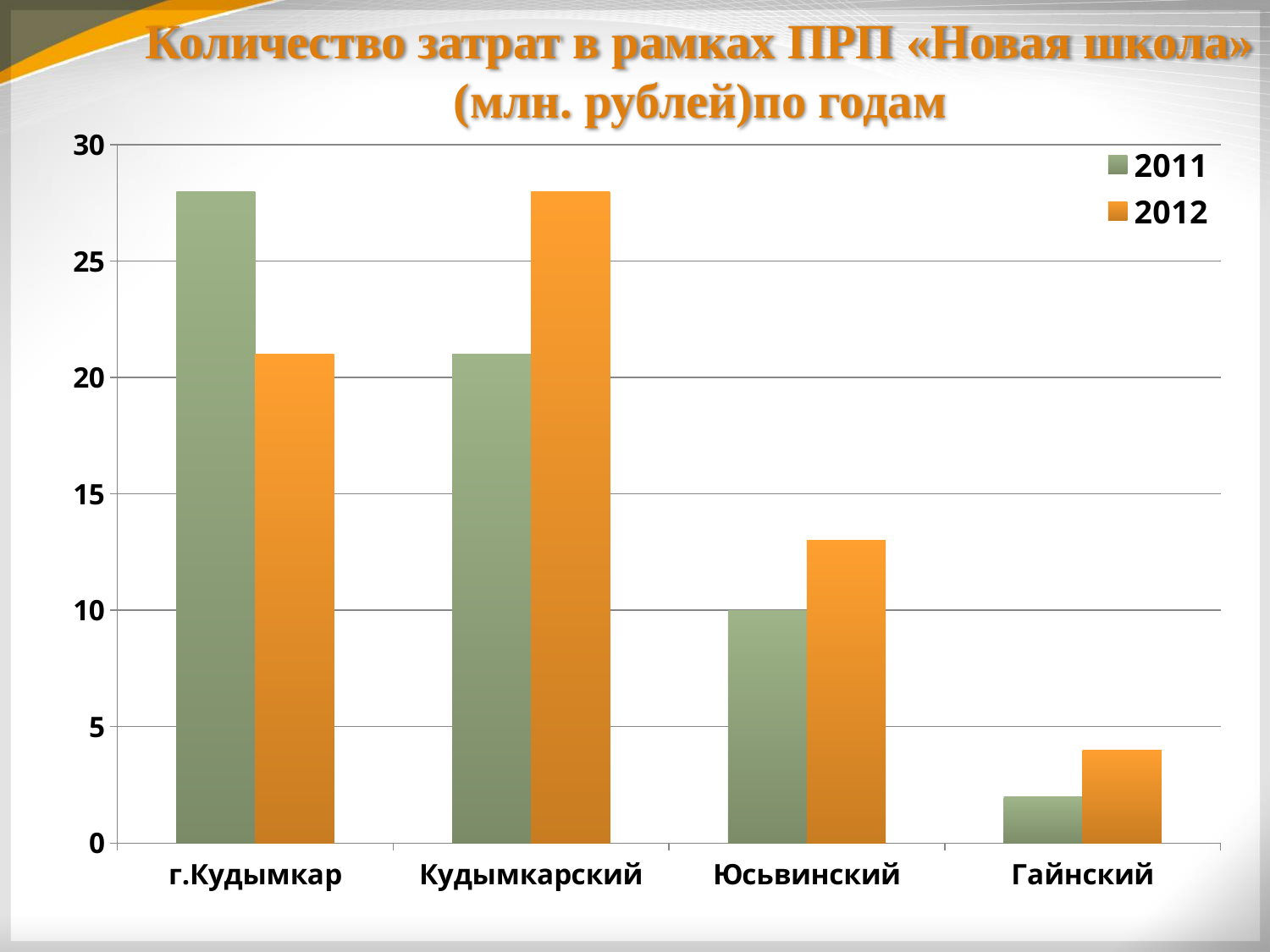
For г.Кудымкар, which year has the larger value, 2011 or 2012? 2011 Which category has the highest value for 2012? Кудымкарский For Кудымкарский, which year has the larger value, 2011 or 2012? 2012 Is the 2012 value for Юсьвинский greater or less than 10? greater How many categories are shown on the x axis? 4 How many series does the legend list? 2 Which category has the highest value for 2011? г.Кудымкар Is the 2011 value for г.Кудымкар greater or less than 25? greater Which category has the lowest value for 2012? Гайнский Is the 2012 value for Гайнский greater or less than 5? less Which colour represents the 2012 series in the legend? orange What kind of chart is shown on the slide? bar chart